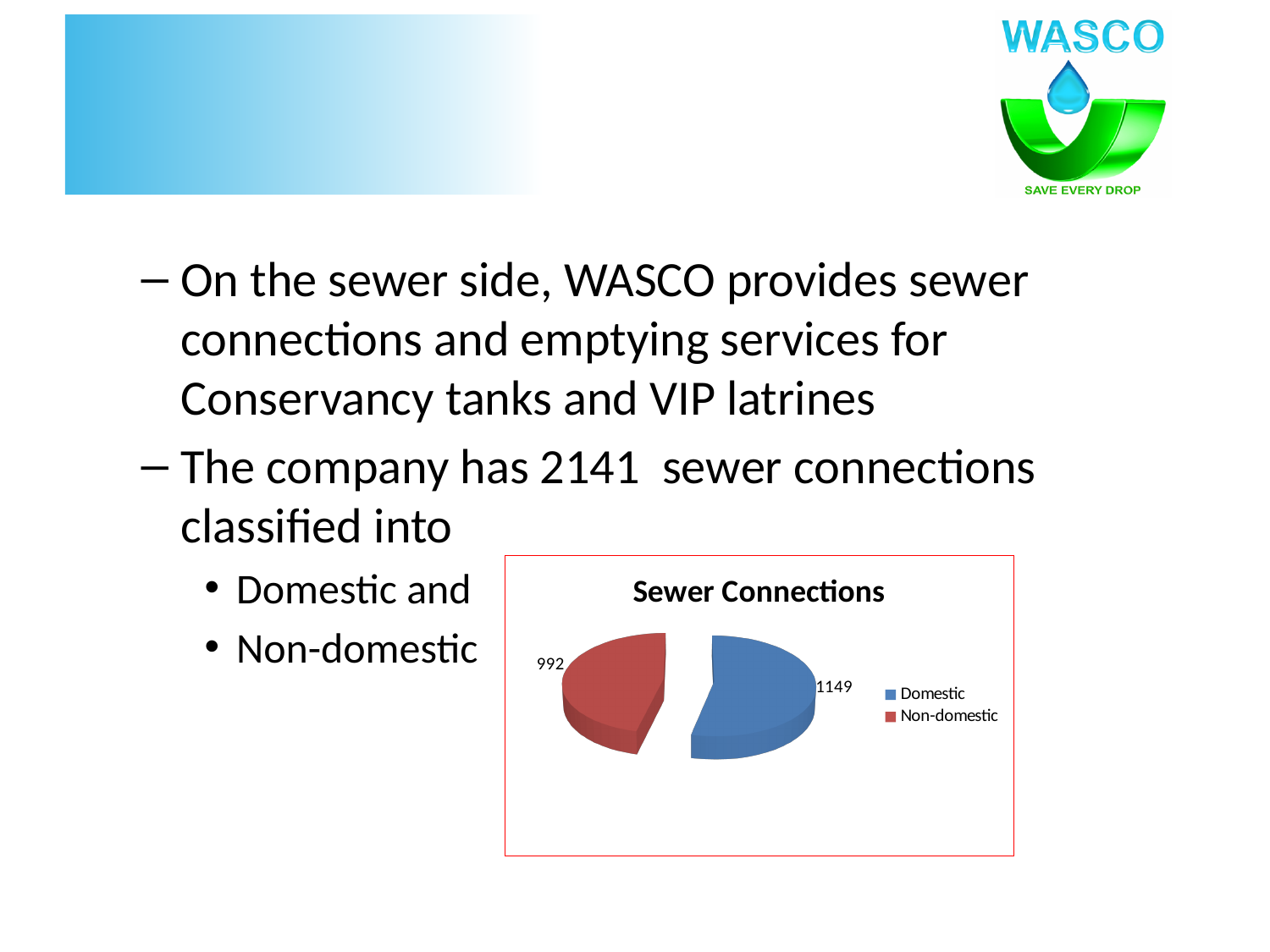
Which category has the largest slice in the Sewer Connections chart? Domestic Which colour represents Non-domestic in the Sewer Connections chart? Red What is the value for Non-domestic in the Sewer Connections pie chart? 992 How many categories are shown in the Sewer Connections pie chart? 2 Which is larger in the Sewer Connections chart, Domestic or Non-domestic? Domestic What type of chart is used to show Sewer Connections? Pie chart What is the value for Domestic in the Sewer Connections pie chart? 1149 What is the title of the chart on the slide? Sewer Connections What is the total of the two values shown in the Sewer Connections pie chart? 2141 Which category has the smallest slice in the Sewer Connections chart? Non-domestic What is the difference between the Domestic and Non-domestic values in the Sewer Connections chart? 157